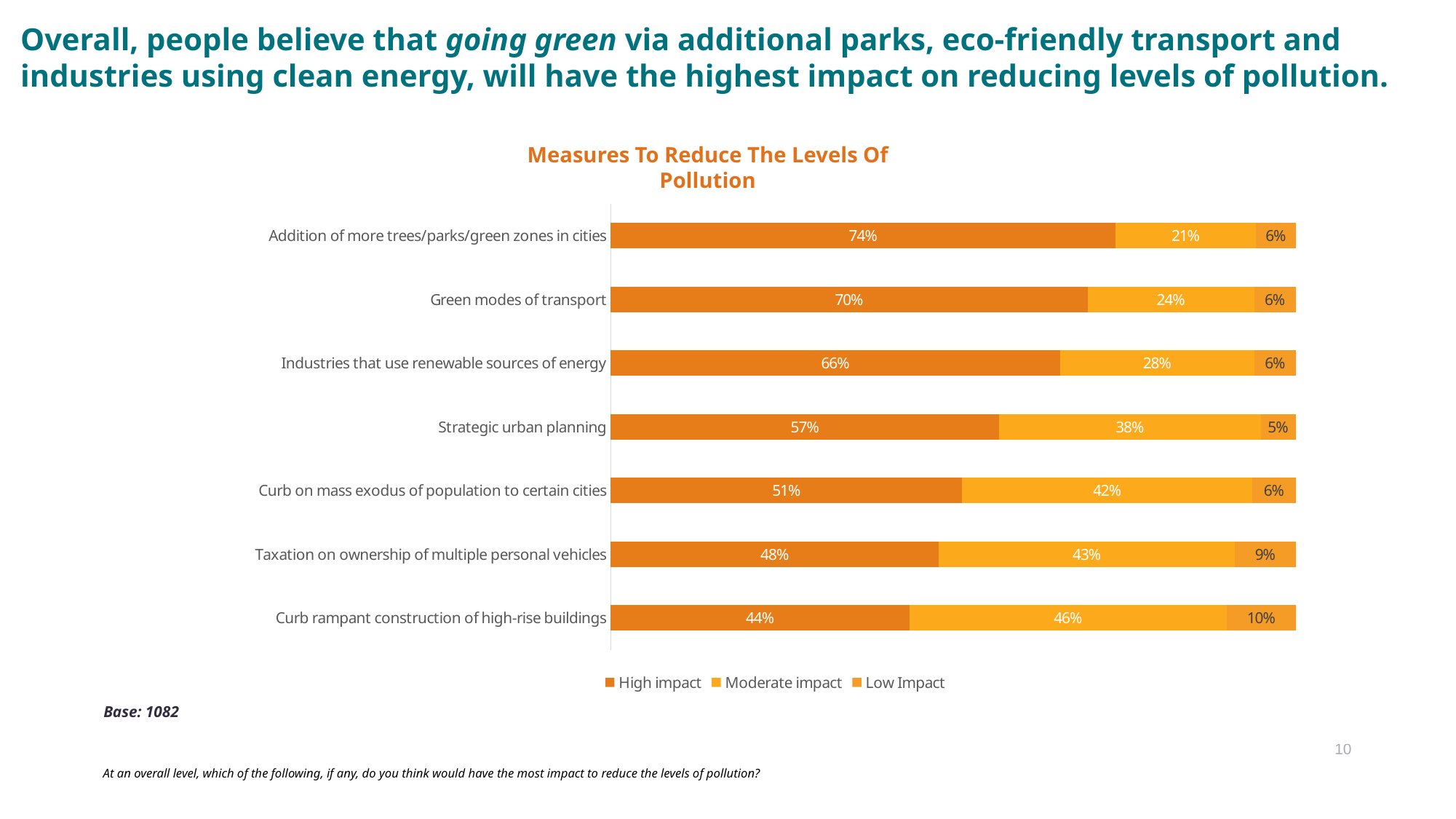
What is the title of the chart? Measures To Reduce The Levels Of Pollution Which has a larger Moderate impact value: Curb on mass exodus of population to certain cities or Taxation on ownership of multiple personal vehicles? Taxation on ownership of multiple personal vehicles Which measure has the highest High impact value? Addition of more trees/parks/green zones in cities How many series does the legend list? 3 What is the total of the stacked bar for Taxation on ownership of multiple personal vehicles? 100% How many measures are shown in the chart? 7 What is the Moderate impact value for Strategic urban planning? 38% What is the High impact value for Green modes of transport? 70% Which measure has the lowest High impact value? Curb rampant construction of high-rise buildings What is the difference between the High impact values for Addition of more trees/parks/green zones in cities and Industries that use renewable sources of energy? 8% What is the Low Impact value for Curb rampant construction of high-rise buildings? 10% What kind of chart is shown on the slide? Stacked bar chart